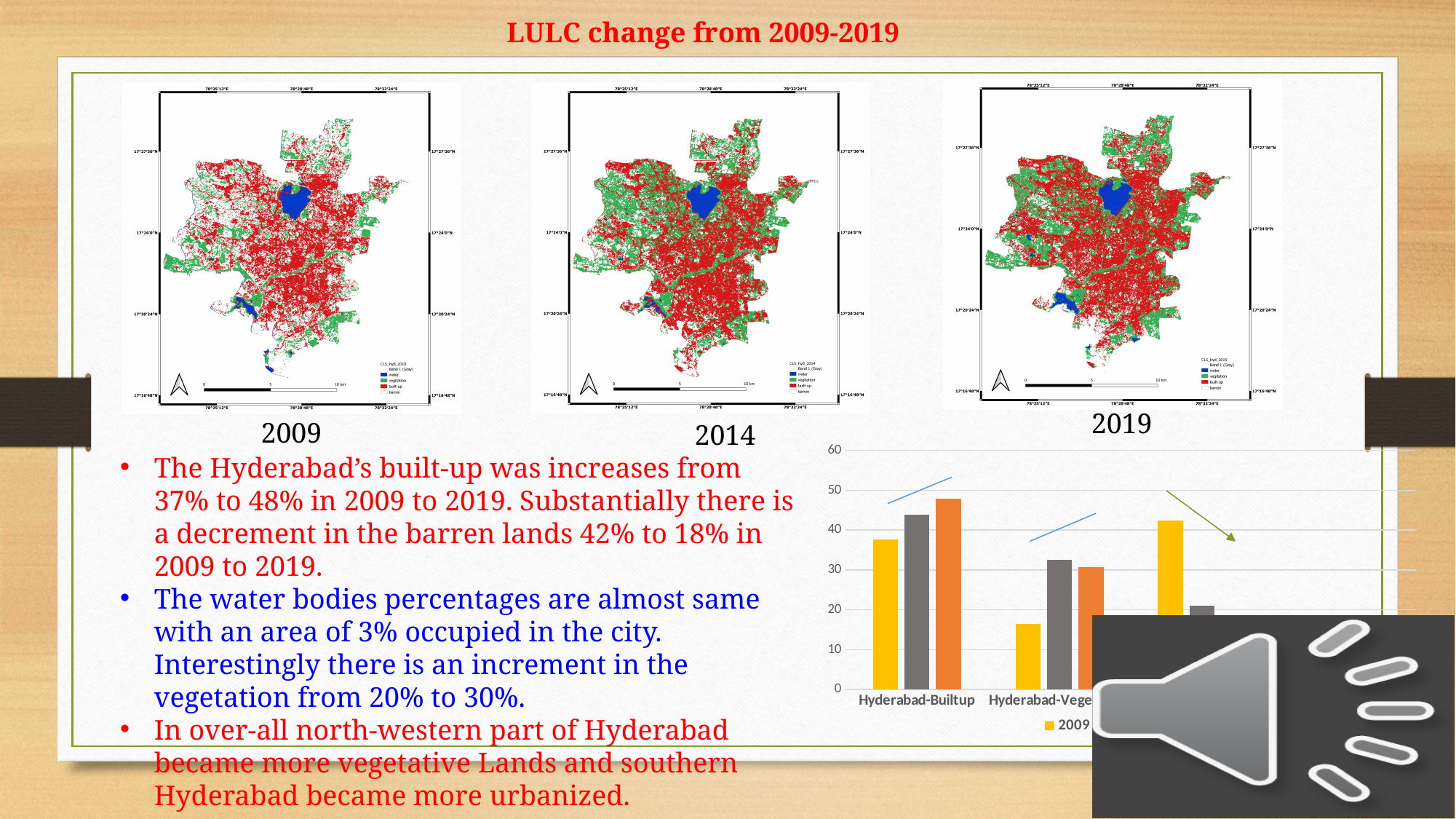
What is the highest value shown on the y axis of the bar chart? 60 In the bar chart, which is larger for 2009: Hyderabad-Builtup or Hyderabad-Vegetation? Hyderabad-Builtup What kind of chart is shown at the bottom right of the slide? bar chart In the bar chart, which of the three bars for Hyderabad-Builtup is the tallest? the orange bar In the bar chart, is the orange bar for Hyderabad-Builtup greater or less than 40? greater In the bar chart, for Hyderabad-Vegetation, which bar is taller: the yellow (2009) bar or the grey bar? the grey bar In the bar chart, is the 2009 value for Hyderabad-Builtup greater or less than 30? greater What is the first entry shown in the legend of the bar chart? 2009 In the bar chart, is the 2009 value for Hyderabad-Vegetation greater or less than 20? less In the bar chart, do the three bars for Hyderabad-Builtup rise or fall from left to right? rise